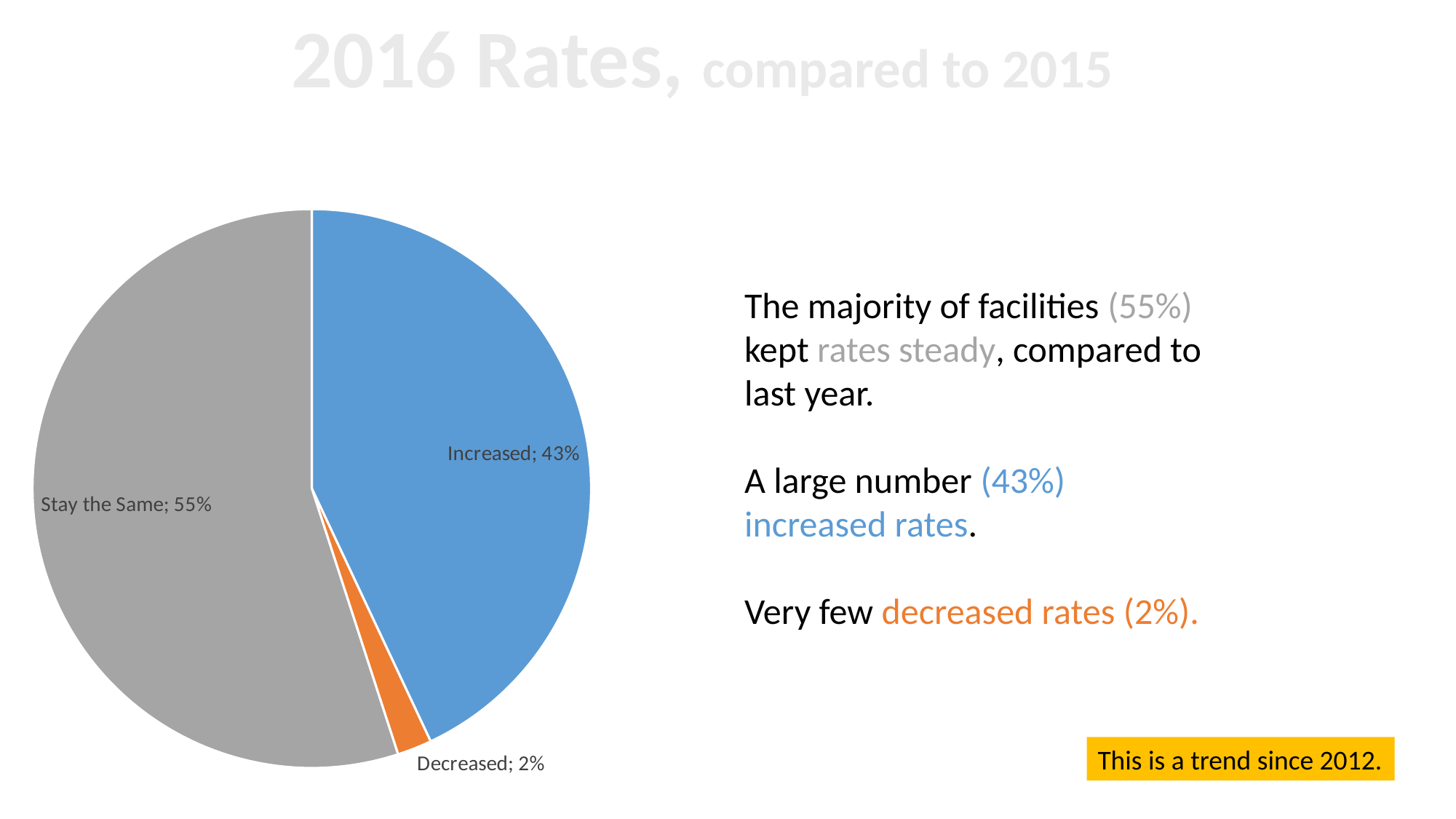
What is the title of the slide? 2016 Rates, compared to 2015 What is the difference in percentage points between Stay the Same and Increased? 12 What kind of chart is shown on the slide? pie chart How many slices does the pie chart have? 3 Which category has the largest share of the pie? Stay the Same What percentage of facilities kept rates the same? 55% What is the difference in percentage points between Increased and Decreased? 41 What percentage of facilities increased rates? 43% Which is larger, the Increased slice or the Decreased slice? Increased What colour is the Decreased slice? orange What percentage of facilities decreased rates? 2% Which category has the smallest share of the pie? Decreased